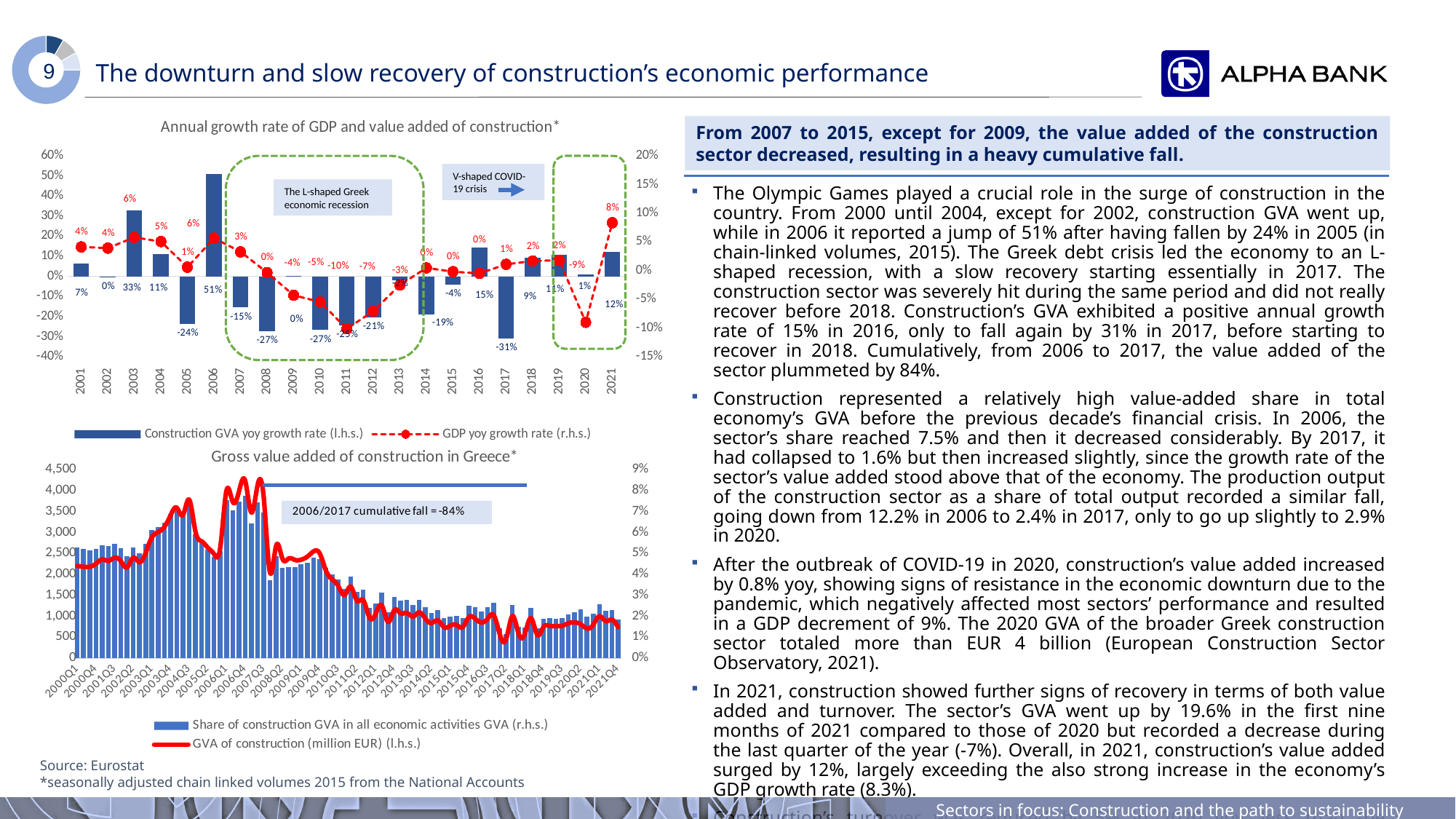
In the chart 'Annual growth rate of GDP and value added of construction', what was the GDP yoy growth rate in 2020? -9% In the chart 'Annual growth rate of GDP and value added of construction', which year had the highest construction GVA yoy growth rate? 2006 How many series does the legend of the chart 'Annual growth rate of GDP and value added of construction' list? 2 In the chart 'Annual growth rate of GDP and value added of construction', what was the construction GVA yoy growth rate in 2017? -31% In the chart 'Annual growth rate of GDP and value added of construction', what was the GDP yoy growth rate in 2021? 8% In the chart 'Annual growth rate of GDP and value added of construction', which year had the higher construction GVA growth rate, 2003 or 2004? 2003 In the chart 'Annual growth rate of GDP and value added of construction', by how many percentage points did the construction GVA growth rate (12%) exceed the GDP growth rate (8%) in 2021? 4 percentage points In the chart 'Annual growth rate of GDP and value added of construction', which year had the lowest construction GVA yoy growth rate? 2017 In the chart 'Gross value added of construction in Greece', what cumulative fall is annotated for 2006/2017? -84% What kind of chart is 'Annual growth rate of GDP and value added of construction'? Combined bar and line chart In the chart 'Gross value added of construction in Greece', is the GVA of construction at 2006Q4 greater or less than 3,500 million EUR? greater In the chart 'Annual growth rate of GDP and value added of construction', what was the construction GVA yoy growth rate in 2006? 51%